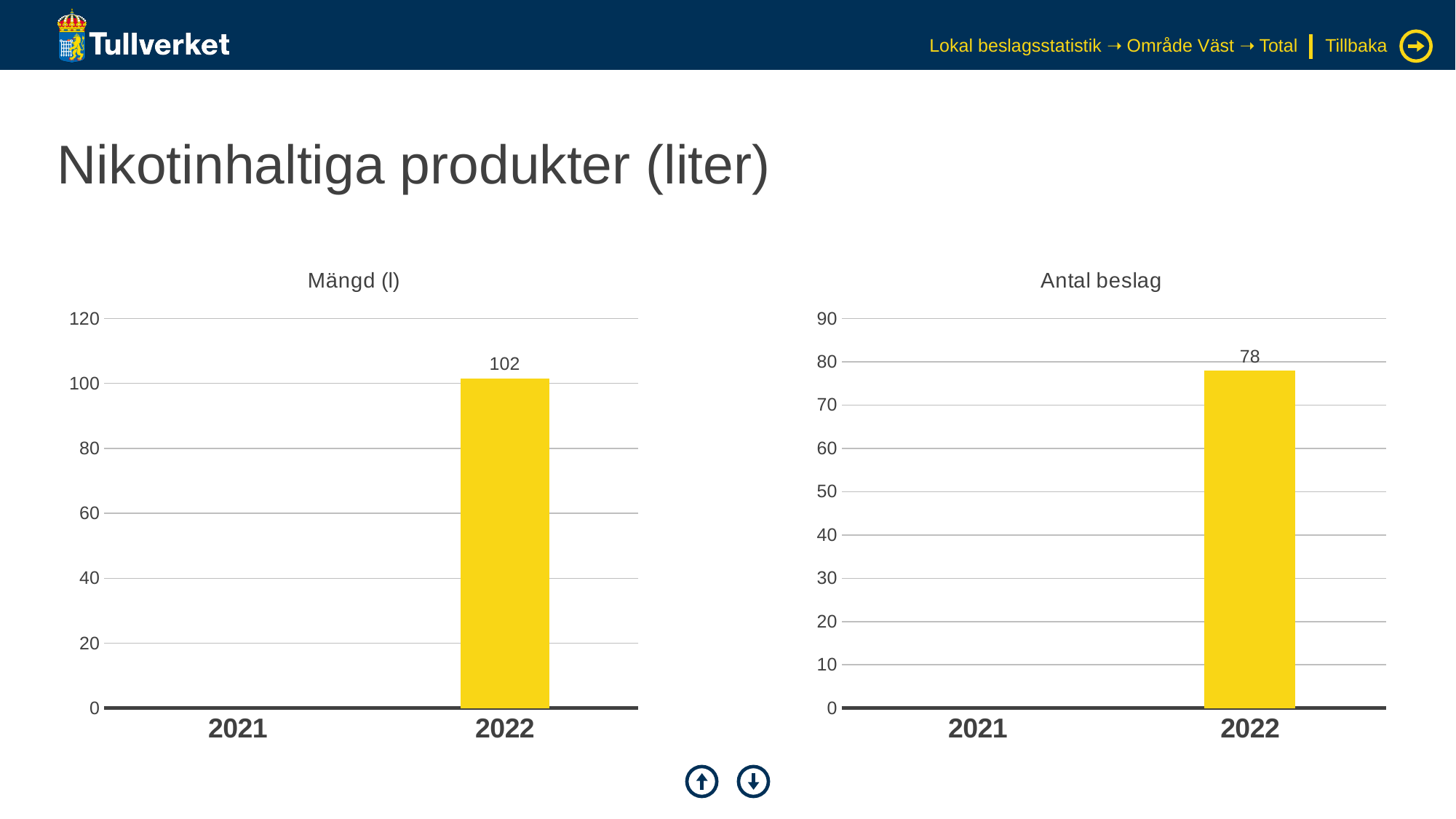
What kind of chart is the "Antal beslag" chart? Bar chart In the "Antal beslag" chart, is the value for 2022 greater or less than 80? less What is the highest value shown on the y axis of the "Antal beslag" chart? 90 In the "Mängd (l)" chart, is the value for 2022 greater or less than 100? greater In the "Mängd (l)" chart, which year has the highest value? 2022 How many years are shown on the x axis of the "Mängd (l)" chart? 2 What colour are the bars in the "Mängd (l)" chart? Yellow In the "Antal beslag" chart, what is the value for 2022? 78 In the "Antal beslag" chart, which year has the highest value? 2022 How many years are shown on the x axis of the "Antal beslag" chart? 2 What is the title of the chart on the left side of the slide? Mängd (l) In the "Mängd (l)" chart, what is the value for 2022? 102